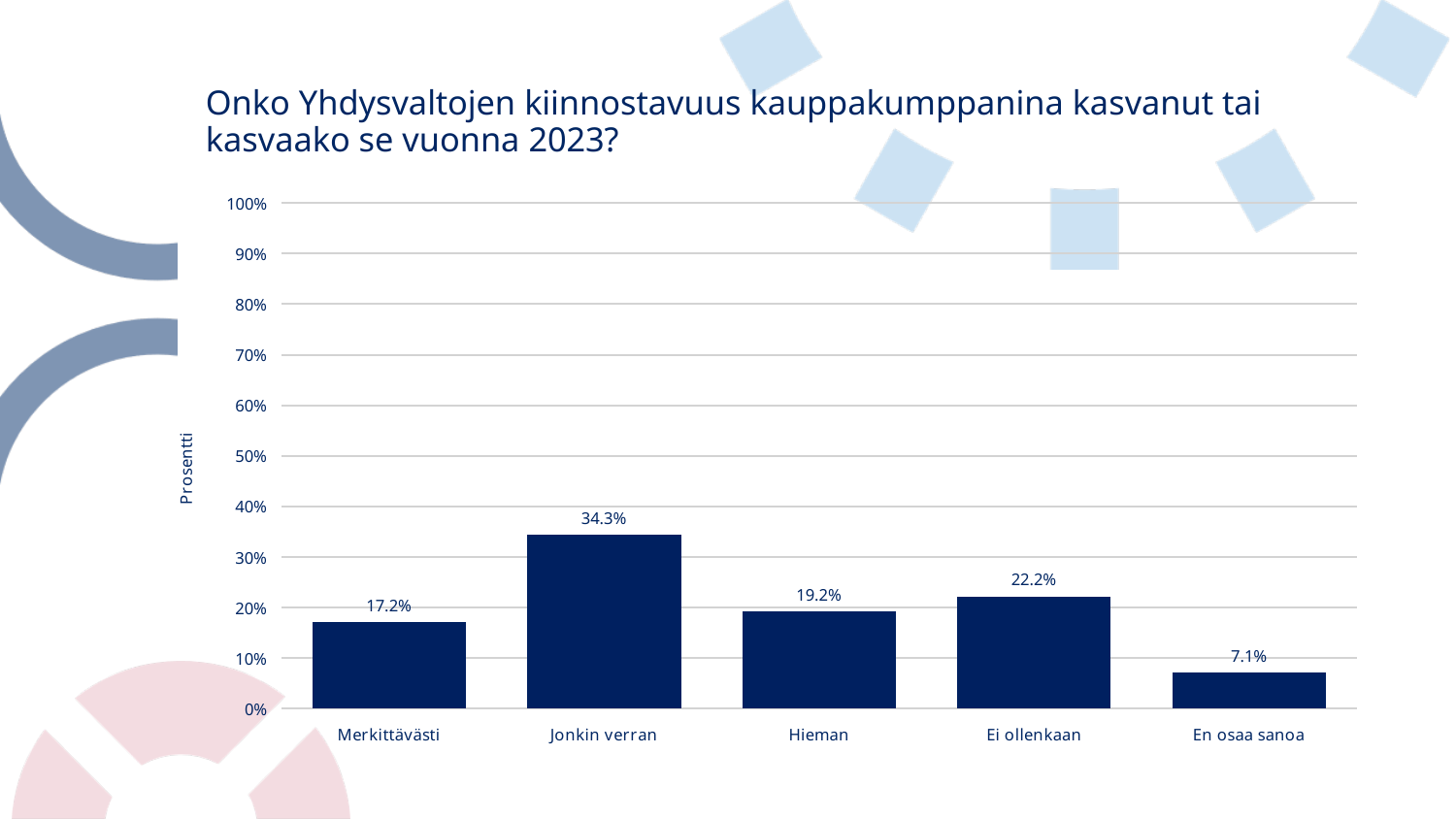
What is the value for "Jonkin verran"? 34.3% Which category has the highest value? Jonkin verran How many categories are shown on the x axis? 5 What is the value for "En osaa sanoa"? 7.1% What is the difference between the values for "Ei ollenkaan" and "Hieman"? 3.0% Is the value for "Merkittävästi" greater or less than 20%? less Which category has the lowest value? En osaa sanoa What is the difference between the values for "Jonkin verran" and "Merkittävästi"? 17.1% What kind of chart is shown on the slide? bar chart Which is larger, the value for "Hieman" or the value for "Ei ollenkaan"? Ei ollenkaan What is the value for "Ei ollenkaan"? 22.2% What is the label of the y axis? Prosentti